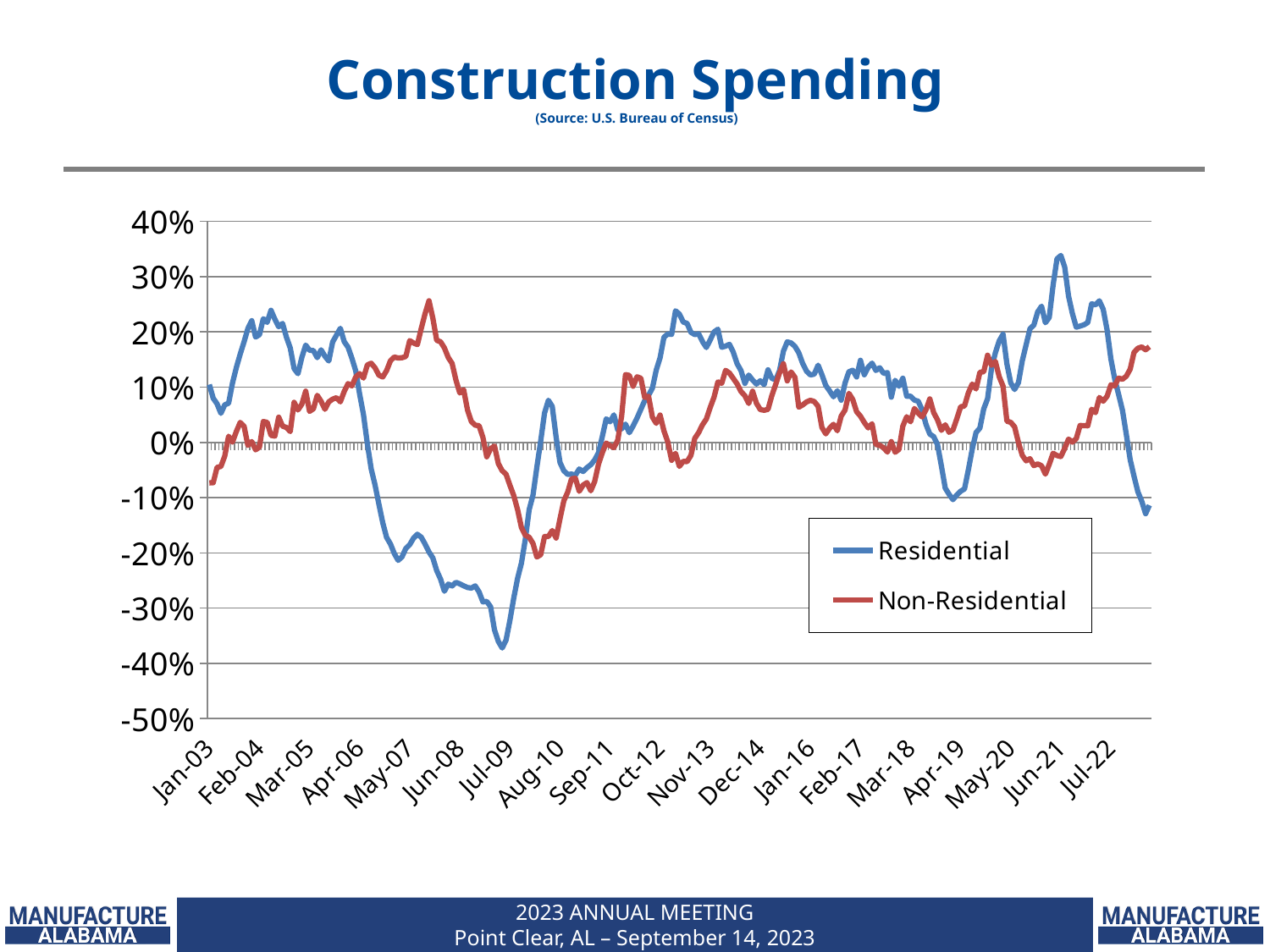
Does the Residential series rise or fall between Apr-06 and Jul-09? Fall At Jul-09, which series has the higher value, Residential or Non-Residential? Non-Residential At May-07, which series has the higher value, Residential or Non-Residential? Non-Residential Is the lowest value reached by the Non-Residential series greater or less than -10%? less Is the highest value reached by the Residential series greater or less than 30%? greater What kind of chart is shown on the slide? Line chart Is the highest value reached by the Non-Residential series greater or less than 20%? greater What is the title of the chart? Construction Spending Which colour is used for the Non-Residential series? Red How many series does the legend list? 2 At Jan-03, which series has the higher value, Residential or Non-Residential? Residential